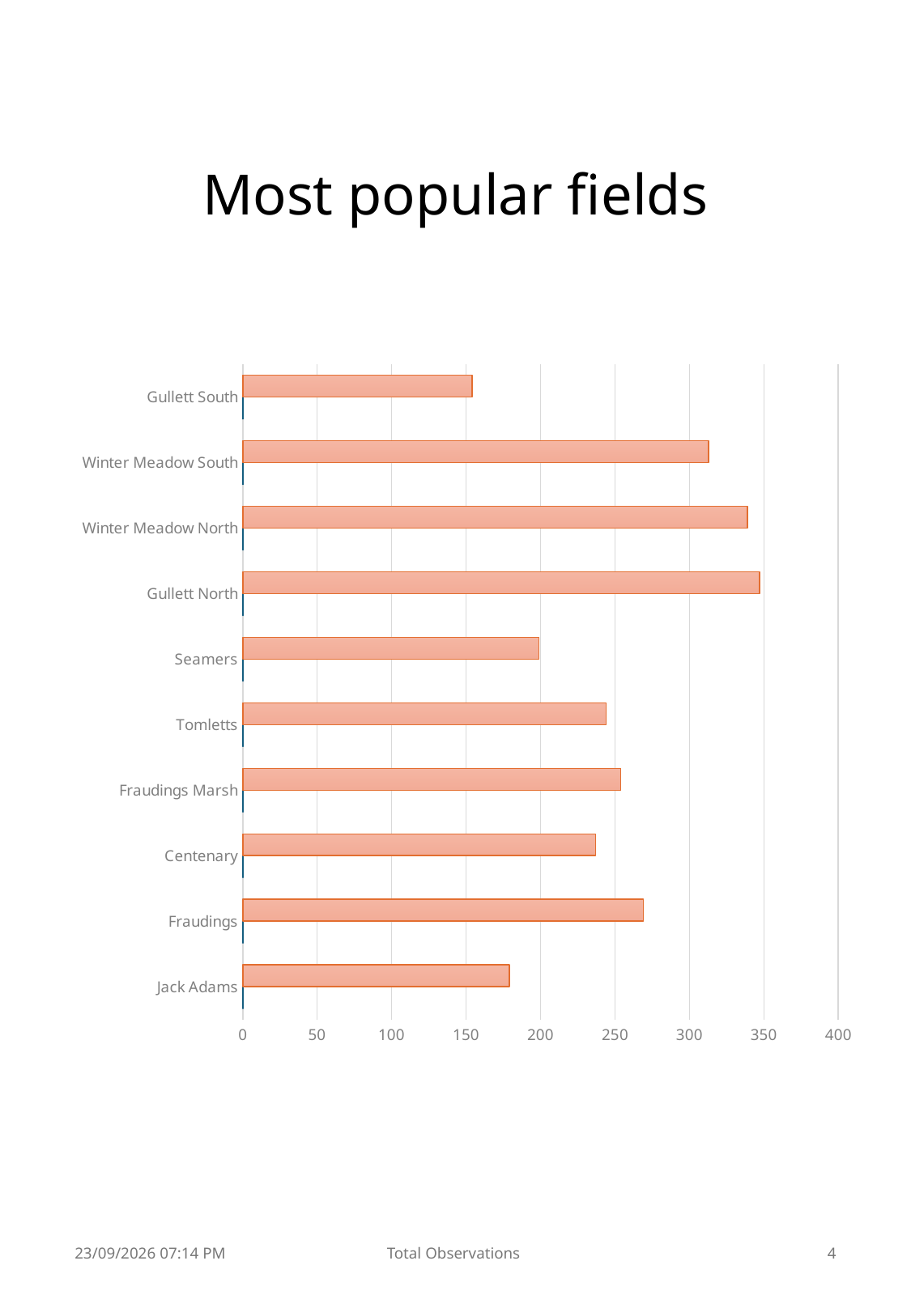
Is the value for Gullett South greater or less than 200? less What kind of chart is shown on the slide? bar chart Is the value for Fraudings greater or less than 250? greater What is the highest value shown on the horizontal axis of the chart? 400 Is the value for Winter Meadow South greater or less than 300? greater What is the title of the chart? Most popular fields Which has the larger value, Winter Meadow South or Tomletts? Winter Meadow South How many fields (categories) are plotted in the chart? 10 Which field has the lowest value in the chart? Gullett South Which has the larger value, Fraudings or Centenary? Fraudings